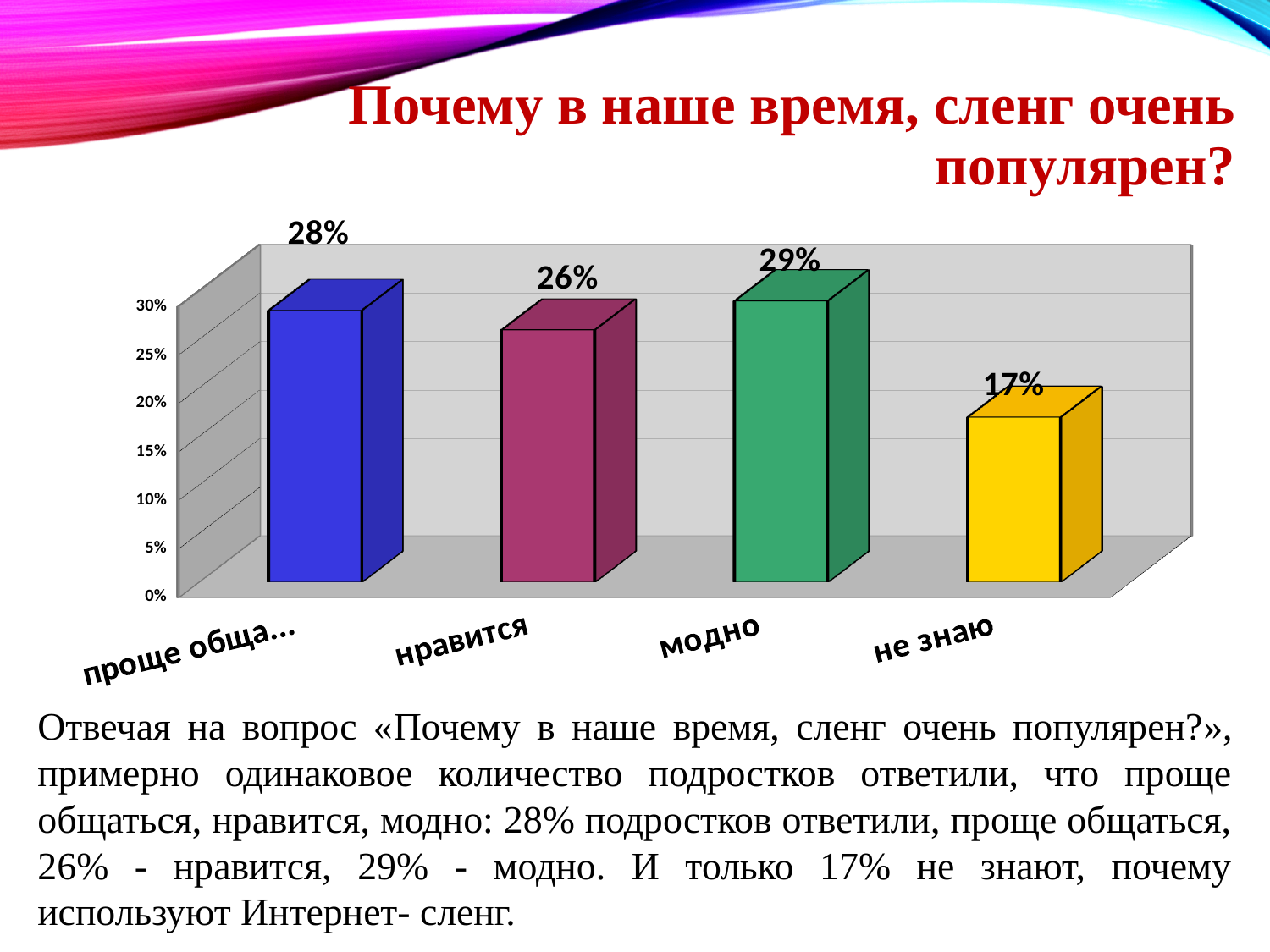
Which category has the highest value in the chart? модно What value is shown for the bar labelled "не знаю"? 17% What is the difference between the values for the leftmost bar ("проще обща...") and "нравится"? 2% What value is shown for the leftmost bar ("проще обща...")? 28% Which is larger, the value for "нравится" or the value for "не знаю"? нравится What value is shown for the bar labelled "модно"? 29% What value is shown for the bar labelled "нравится"? 26% Which category has the lowest value in the chart? не знаю What colour is the bar for "не знаю"? yellow What kind of chart is shown on the slide? bar chart How many categories (bars) are shown in the chart? 4 What is the difference between the values for "модно" and "не знаю"? 12%